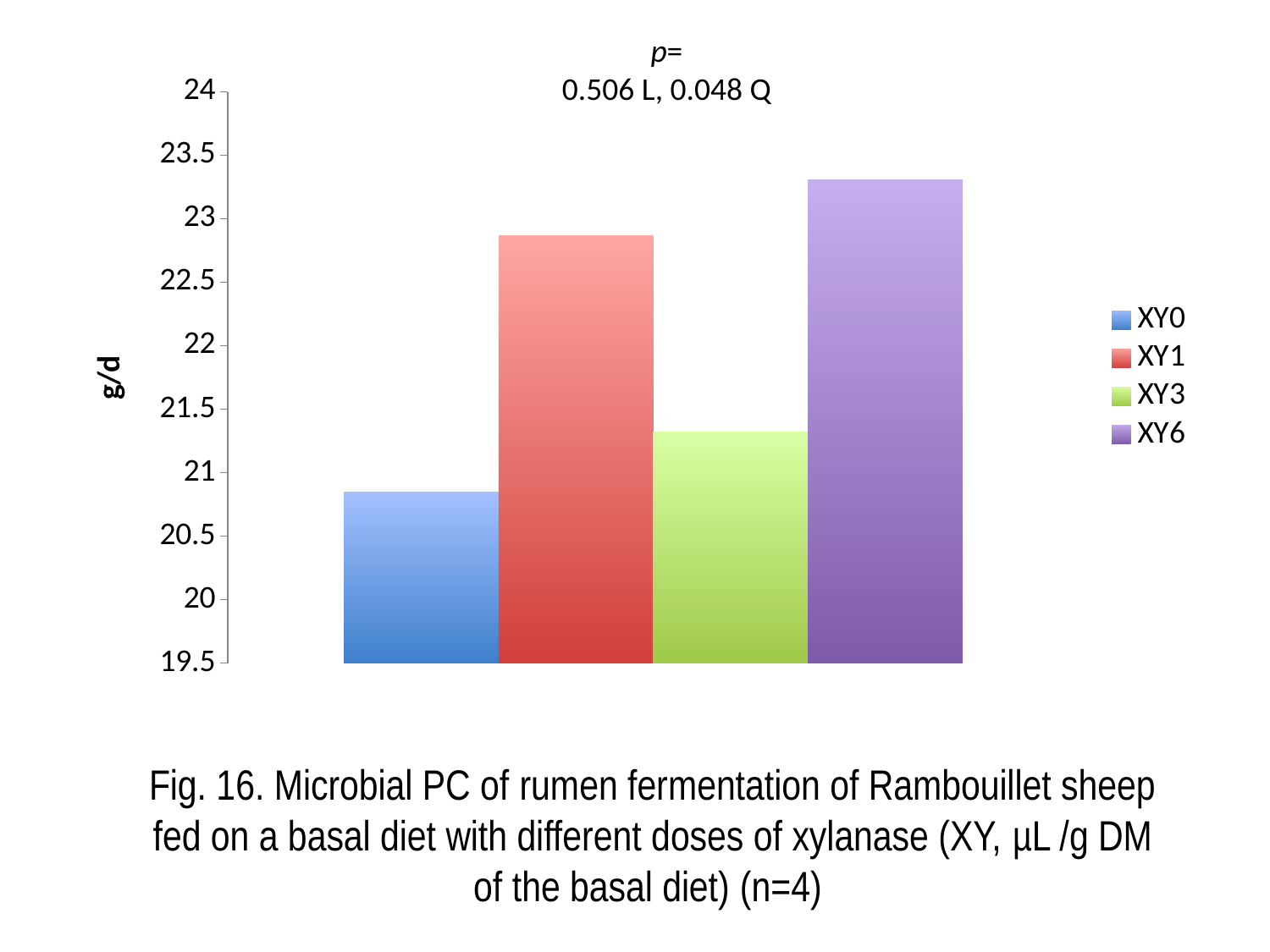
What is the label on the vertical axis of the chart? g/d How many bars are plotted in the chart? 4 Which is larger, the value for XY1 or the value for XY3? XY1 Is the value for XY1 greater or less than 22.5? greater Which treatment has the highest value in the chart? XY6 Which is larger, the value for XY6 or the value for XY1? XY6 What kind of chart is shown on the slide? bar chart Is the value for XY3 greater or less than 21.5? less Is the value for XY0 greater or less than 21? less Which treatment has the lowest value in the chart? XY0 How many entries does the legend list? 4